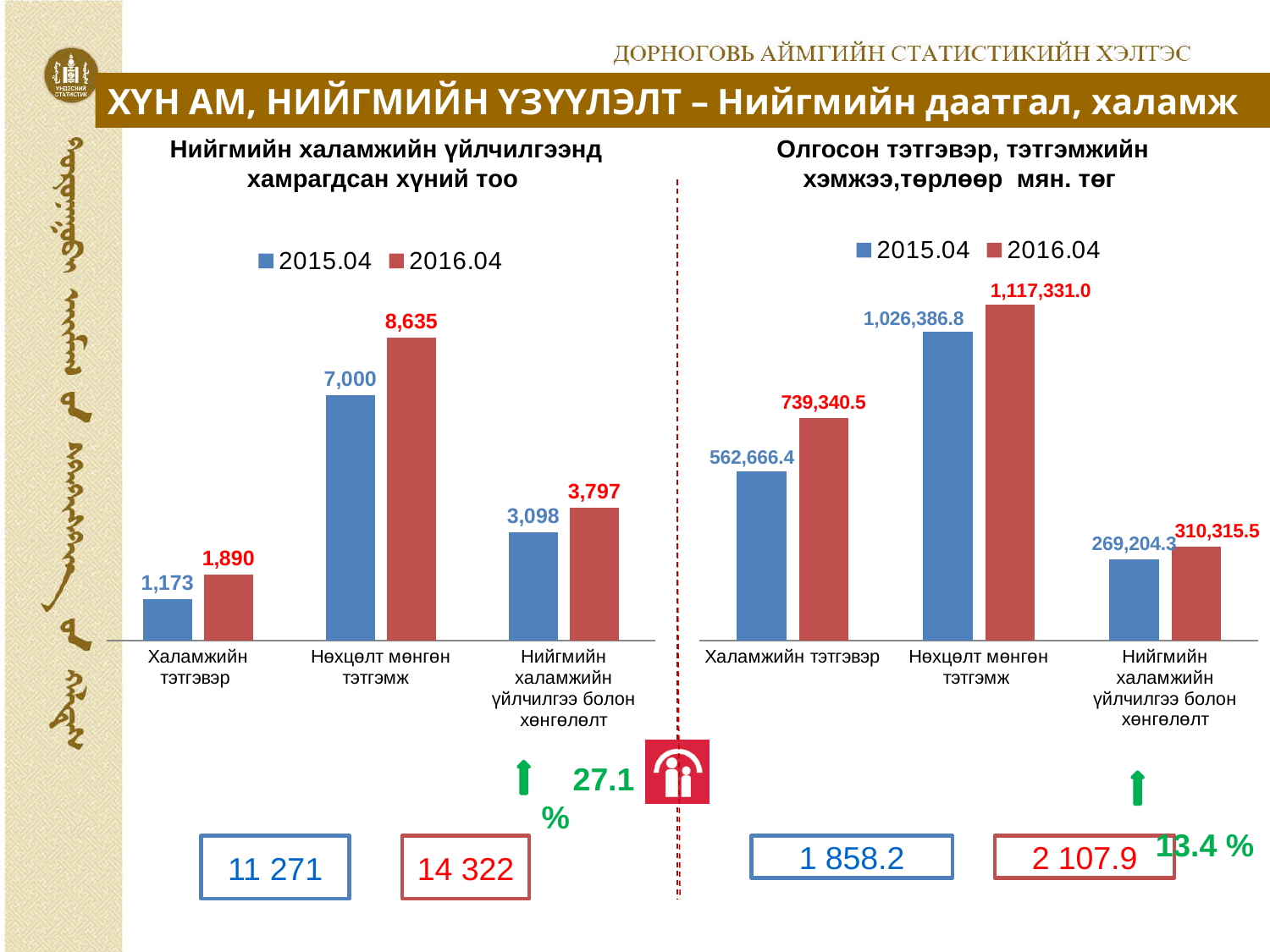
In the right chart (Олгосон тэтгэвэр, тэтгэмжийн хэмжээ, төрлөөр мян. төг), how many categories are shown on the x axis? 3 In the right chart (Олгосон тэтгэвэр, тэтгэмжийн хэмжээ, төрлөөр мян. төг), which category has the highest 2016.04 value? Нөхцөлт мөнгөн тэтгэмж In the left chart (Нийгмийн халамжийн үйлчилгээнд хамрагдсан хүний тоо), how many series does the legend list? 2 In the right chart (Олгосон тэтгэвэр, тэтгэмжийн хэмжээ, төрлөөр мян. төг), what is the 2015.04 value for Нийгмийн халамжийн үйлчилгээ болон хөнгөлөлт? 269,204.3 What kind of chart is the left chart (Нийгмийн халамжийн үйлчилгээнд хамрагдсан хүний тоо)? Bar chart In the right chart (Олгосон тэтгэвэр, тэтгэмжийн хэмжээ, төрлөөр мян. төг), what is the 2016.04 value for Халамжийн тэтгэвэр? 739,340.5 In the left chart (Нийгмийн халамжийн үйлчилгээнд хамрагдсан хүний тоо), what is the 2015.04 value for Халамжийн тэтгэвэр? 1,173 In the left chart (Нийгмийн халамжийн үйлчилгээнд хамрагдсан хүний тоо), what is the 2016.04 value for Нөхцөлт мөнгөн тэтгэмж? 8,635 In the left chart (Нийгмийн халамжийн үйлчилгээнд хамрагдсан хүний тоо), which category has the lowest 2016.04 value? Халамжийн тэтгэвэр In the left chart (Нийгмийн халамжийн үйлчилгээнд хамрагдсан хүний тоо), what is the difference between the 2016.04 and 2015.04 values for Нийгмийн халамжийн үйлчилгээ болон хөнгөлөлт? 699 In the right chart (Олгосон тэтгэвэр, тэтгэмжийн хэмжээ, төрлөөр мян. төг), which is larger for Халамжийн тэтгэвэр: the 2015.04 value or the 2016.04 value? 2016.04 In the left chart (Нийгмийн халамжийн үйлчилгээнд хамрагдсан хүний тоо), which category has the highest 2015.04 value? Нөхцөлт мөнгөн тэтгэмж